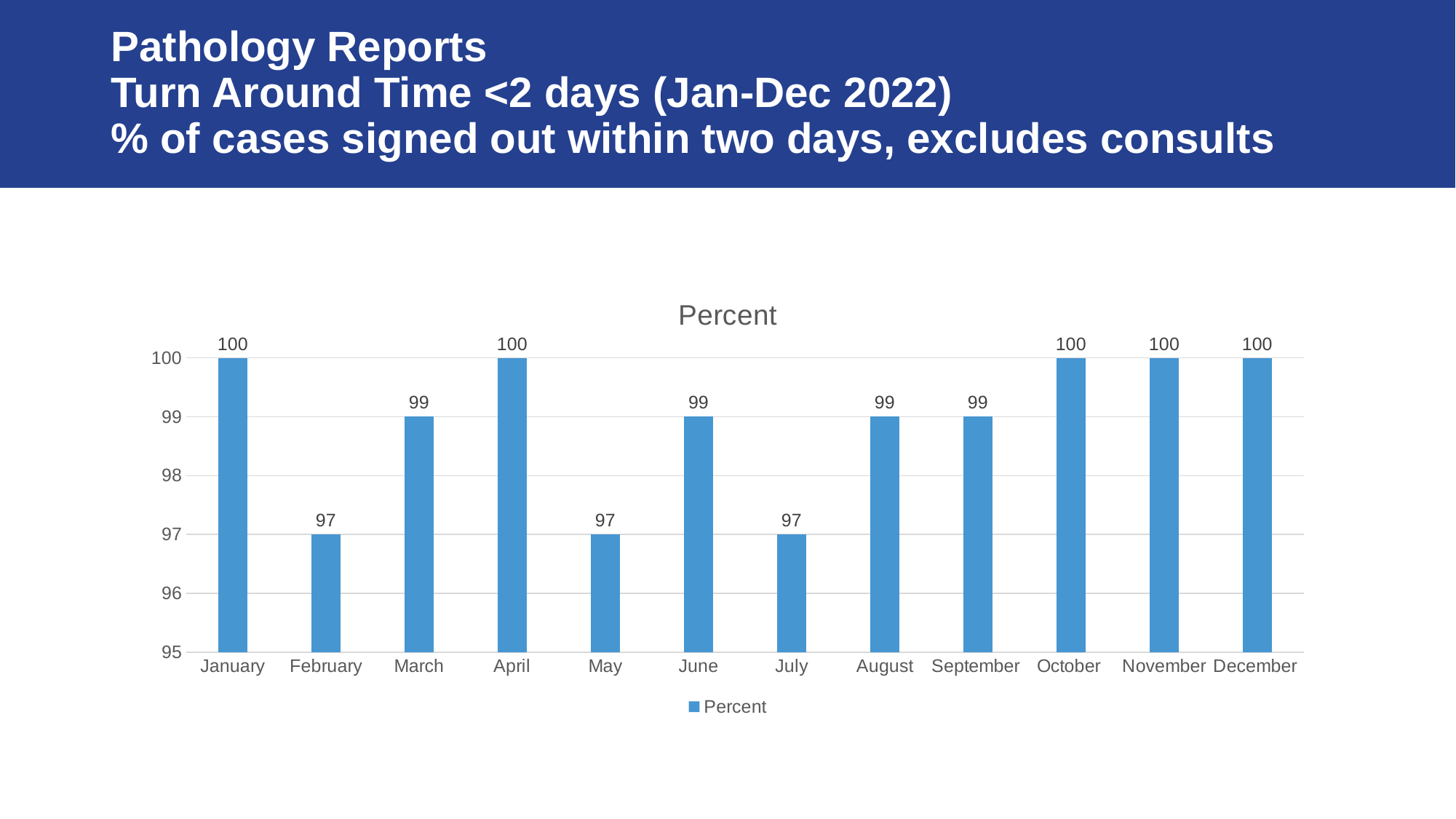
What is the value for March? 99 How many months are shown on the x axis? 12 How many months have a value of 100? 5 What is the title of the chart? Percent What kind of chart is shown on the slide? bar chart Which is larger, the value for June or the value for July? June What is the value for July? 97 How many series does the legend list? 1 What is the value for October? 100 Which month has the lowest value among January, February and March? February Is the value for February greater or less than 98? less What is the difference between the values for April and May? 3